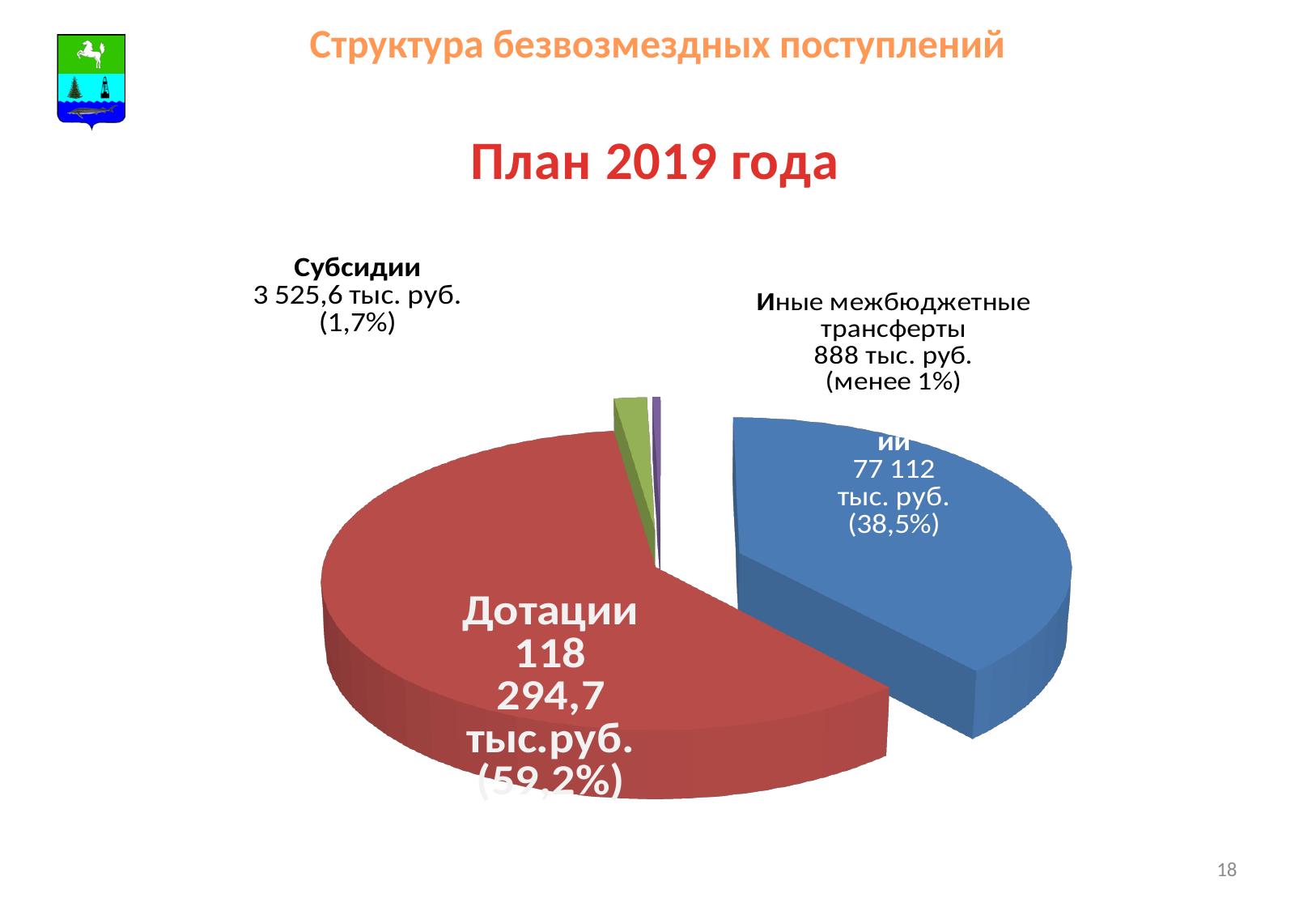
What value is printed for Иные межбюджетные трансферты? 888 тыс. руб. Which is larger, Субсидии or Иные межбюджетные трансферты? Субсидии What value is printed on the blue slice of the pie? 77 112 тыс. руб. What kind of chart is shown on the slide? pie chart What share of the pie does Дотации account for? 59,2% How many slices does the pie chart have? 4 What share of the pie is shown for Иные межбюджетные трансферты? менее 1% What share of the pie does Субсидии account for? 1,7% What value is printed for Дотации? 118 294,7 тыс.руб. What value is printed for Субсидии? 3 525,6 тыс. руб. Which category has the largest slice of the pie? Дотации Which category has the smallest slice of the pie? Иные межбюджетные трансферты